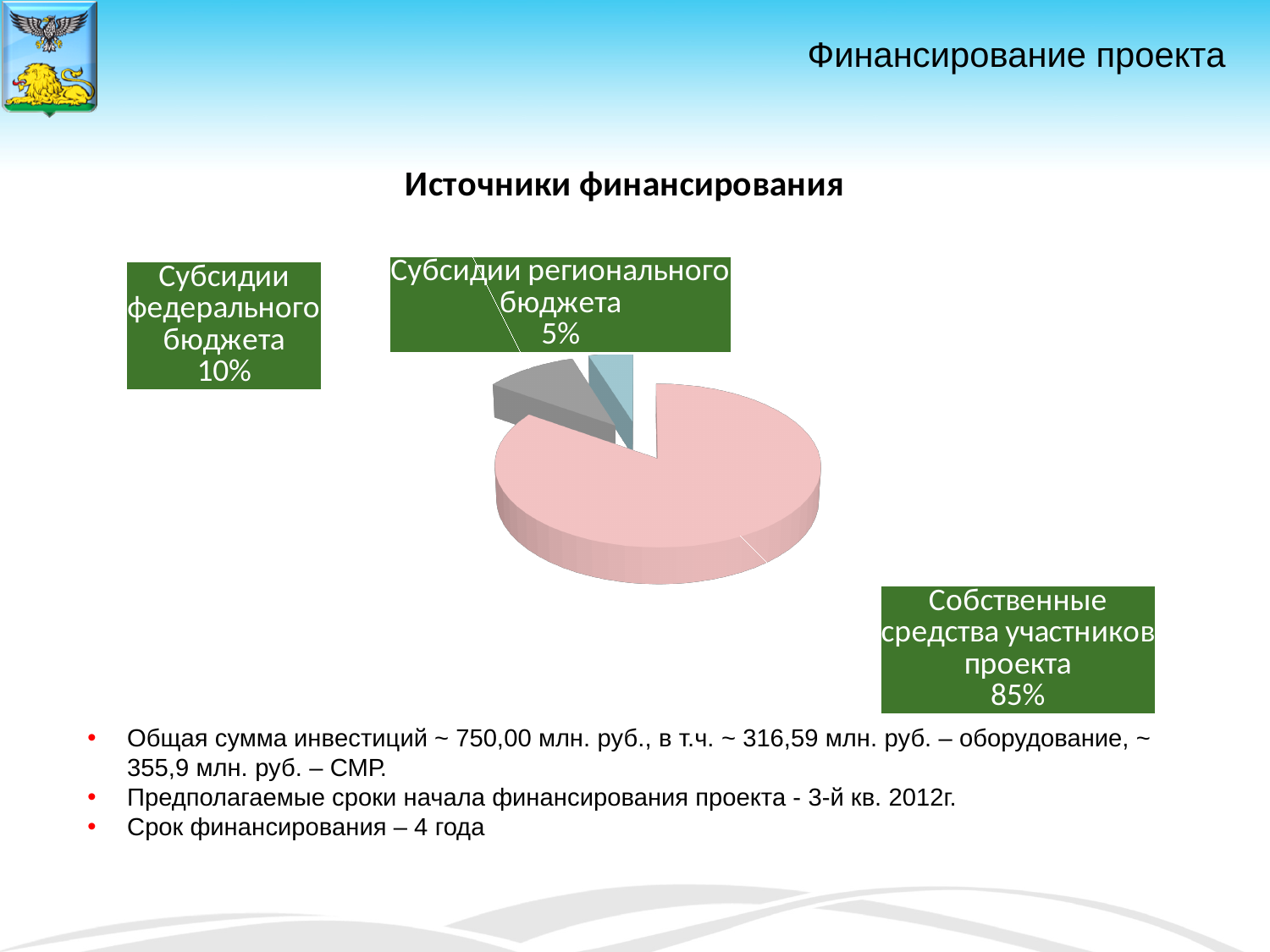
What share of the pie is labelled "Субсидии регионального бюджета"? 5% What kind of chart is shown on the slide? pie chart What is the difference between the share for "Собственные средства участников проекта" and the share for "Субсидии федерального бюджета"? 75% What share of the pie is labelled "Собственные средства участников проекта"? 85% What colour is the largest slice of the pie? pink What share of the pie is labelled "Субсидии федерального бюджета"? 10% How many slices does the pie chart have? 3 Which slice of the pie is the largest? Собственные средства участников проекта What is the difference between the share for "Субсидии федерального бюджета" and the share for "Субсидии регионального бюджета"? 5% What is the title of the chart? Источники финансирования Which slice of the pie is the smallest? Субсидии регионального бюджета Which is larger: the share for "Субсидии федерального бюджета" or the share for "Субсидии регионального бюджета"? Субсидии федерального бюджета